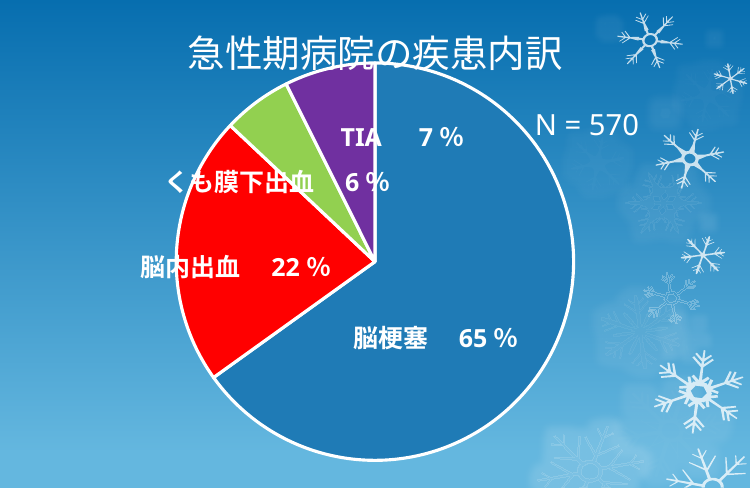
What share of the pie does くも膜下出血 account for? 6 % What kind of chart is shown on the slide? pie chart What share of the pie does 脳梗塞 account for? 65 % What share of the pie does 脳内出血 account for? 22 % Which category has the smallest slice of the pie? くも膜下出血 What is the total sample size (N) shown on the slide? N = 570 Which category has the largest slice of the pie? 脳梗塞 What is the difference in percentage points between 脳梗塞 and 脳内出血? 43 % What is the title of the chart? 急性期病院の疾患内訳 How many slices does the pie chart have? 4 Which is larger, the share for TIA or the share for くも膜下出血? TIA